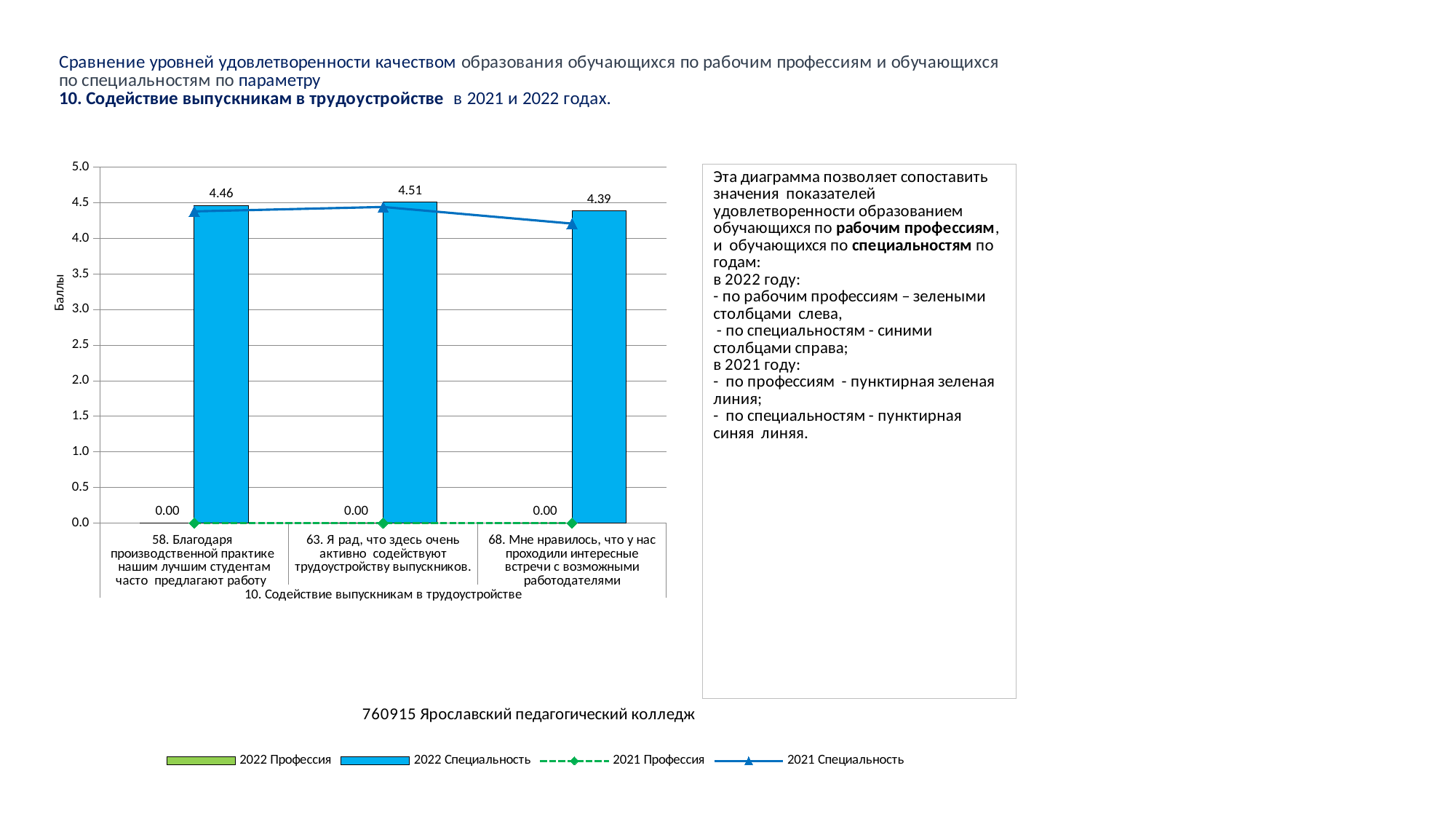
Which category has the lowest 2022 Специальность value? 68. Мне нравилось, что у нас проходили интересные встречи с возможными работодателями What is the value of the 2022 Специальность bar for category 63 (Я рад, что здесь очень активно содействуют трудоустройству выпускников)? 4.51 How many series does the chart legend list? 4 What is the value of the 2022 Специальность bar for category 58 (Благодаря производственной практике нашим лучшим студентам часто предлагают работу)? 4.46 Is the 2021 Специальность value for category 68 greater or less than 4.5? less What is the value of the 2022 Специальность bar for category 68 (Мне нравилось, что у нас проходили интересные встречи с возможными работодателями)? 4.39 What is the difference between the 2022 Специальность values for category 63 and category 68? 0.12 What is the label of the vertical axis of the chart? Баллы Which category has the highest 2022 Специальность value? 63. Я рад, что здесь очень активно содействуют трудоустройству выпускников. How many categories are shown on the x axis of the chart? 3 Which is larger, the 2022 Специальность value for category 58 or for category 68? Category 58 (4.46) What value is labelled for the 2022 Профессия series in each category? 0.00